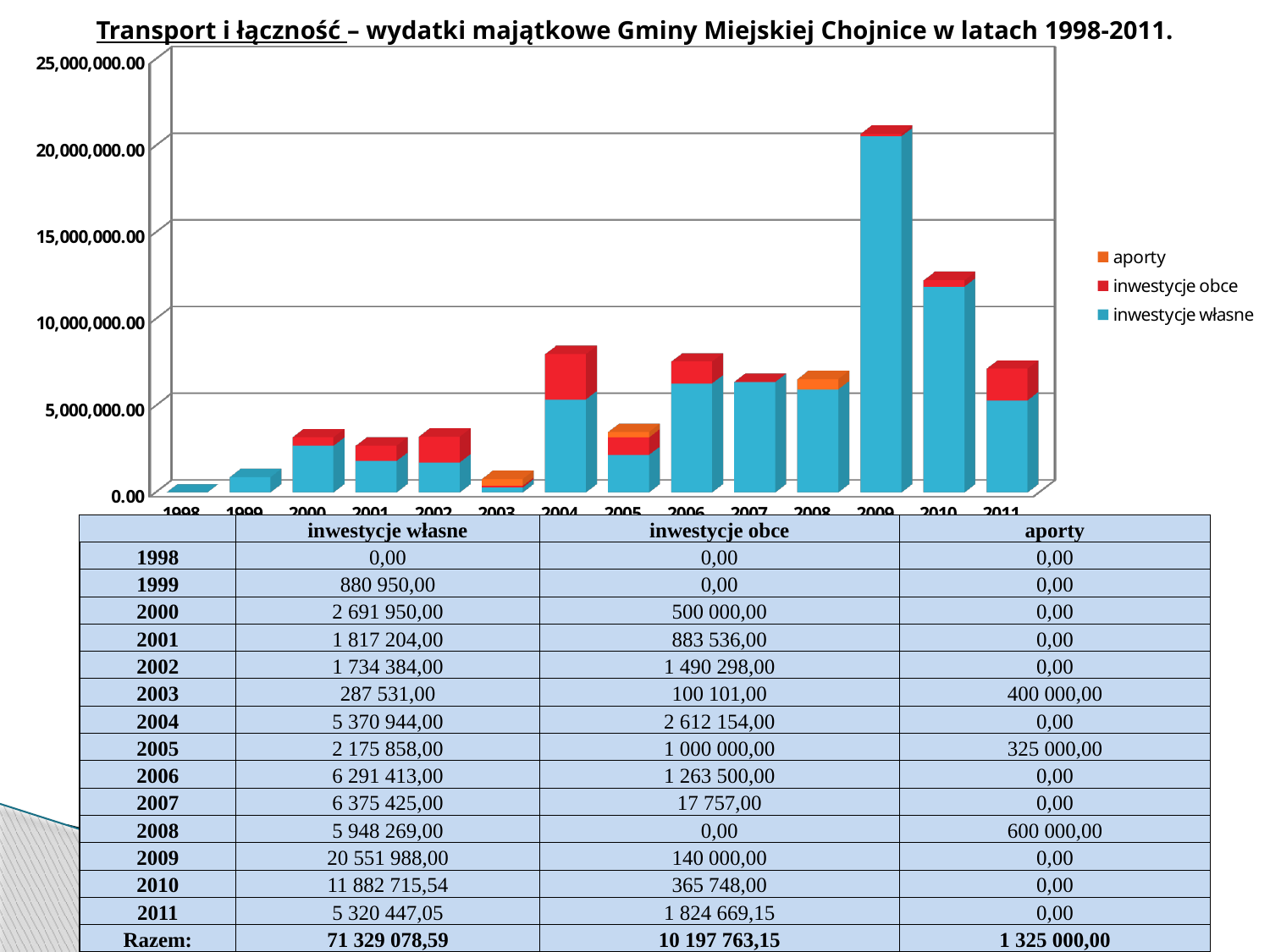
What is the value of inwestycje obce for 2004? 2 612 154,00 What kind of chart is shown on the slide? bar chart Which colour represents aporty in the chart legend? orange How many series does the chart legend list? 3 What is the value of inwestycje własne for 2009? 20 551 988,00 What is the value of aporty for 2008? 600 000,00 What is the total of the stacked bar for 2003? 787 632,00 What is the difference between inwestycje własne in 2010 and in 2011? 6 562 268,49 Which year has the highest value of inwestycje własne? 2009 Is the total value of the bar for 2009 greater or less than 20,000,000.00? greater Which year has the highest value of inwestycje obce? 2004 How many years are shown on the x axis of the chart? 14